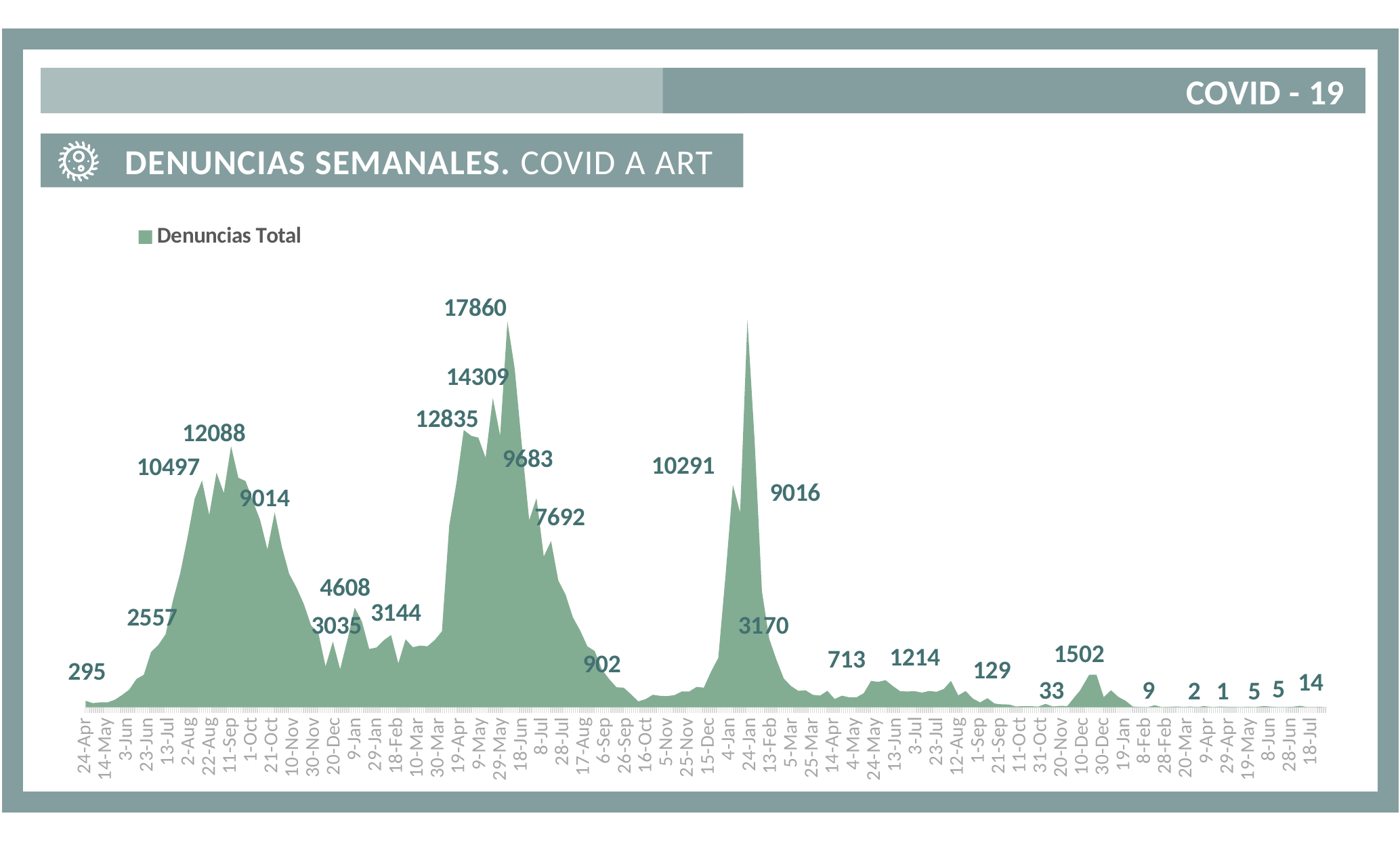
What is the difference between the labelled values 12088 and 10497? 1591 Which labelled value is larger, 12088 or 10291? 12088 What is the name of the series shown in the legend? Denuncias Total What is the lowest value labelled on the chart? 1 What is the highest value labelled on the chart? 17860 What is the difference between the labelled values 17860 and 14309? 3551 What is the title of the chart? DENUNCIAS SEMANALES. COVID A ART Do the values rise or fall along the x axis from the 17860 peak to the end of the chart? fall What is the value labelled at the first point of the chart (24-Apr)? 295 How many series does the legend list? 1 What is the value labelled at the last point of the chart (18-Jul)? 14 What kind of chart is shown on the slide? area chart